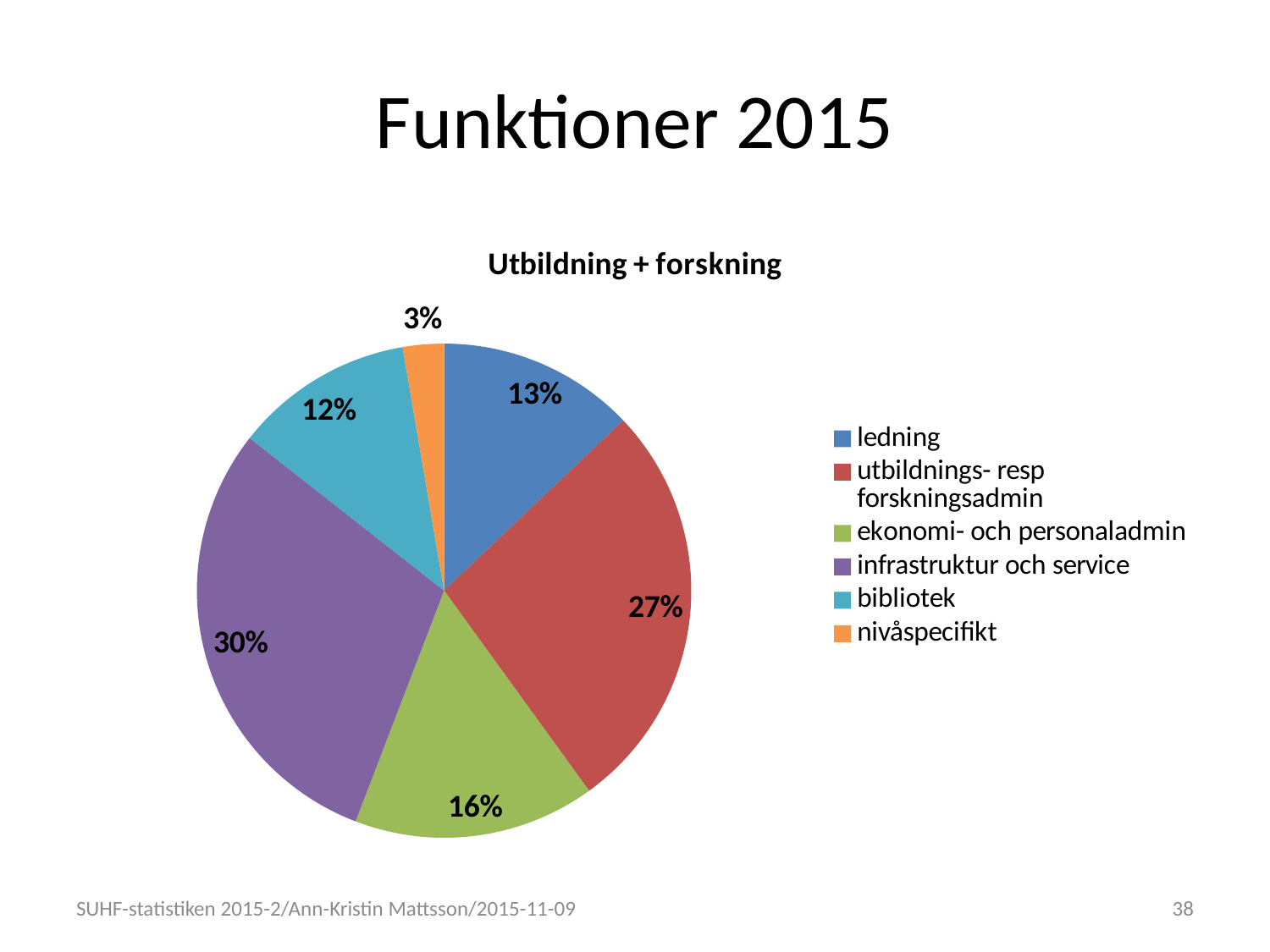
What share of the pie does 'bibliotek' have? 12% What type of chart is shown on the slide? pie chart What share of the pie does 'ekonomi- och personaladmin' have? 16% What share of the pie does 'nivåspecifikt' have? 3% What is the title of the chart? Utbildning + forskning What share of the pie does 'infrastruktur och service' have? 30% What is the difference in percentage points between 'utbildnings- resp forskningsadmin' and 'ekonomi- och personaladmin'? 11 Which is larger, the share for 'ledning' or the share for 'bibliotek'? ledning What share of the pie does 'ledning' have? 13% How many categories does the legend list? 6 Which category has the largest share of the pie? infrastruktur och service Which category has the smallest share of the pie? nivåspecifikt